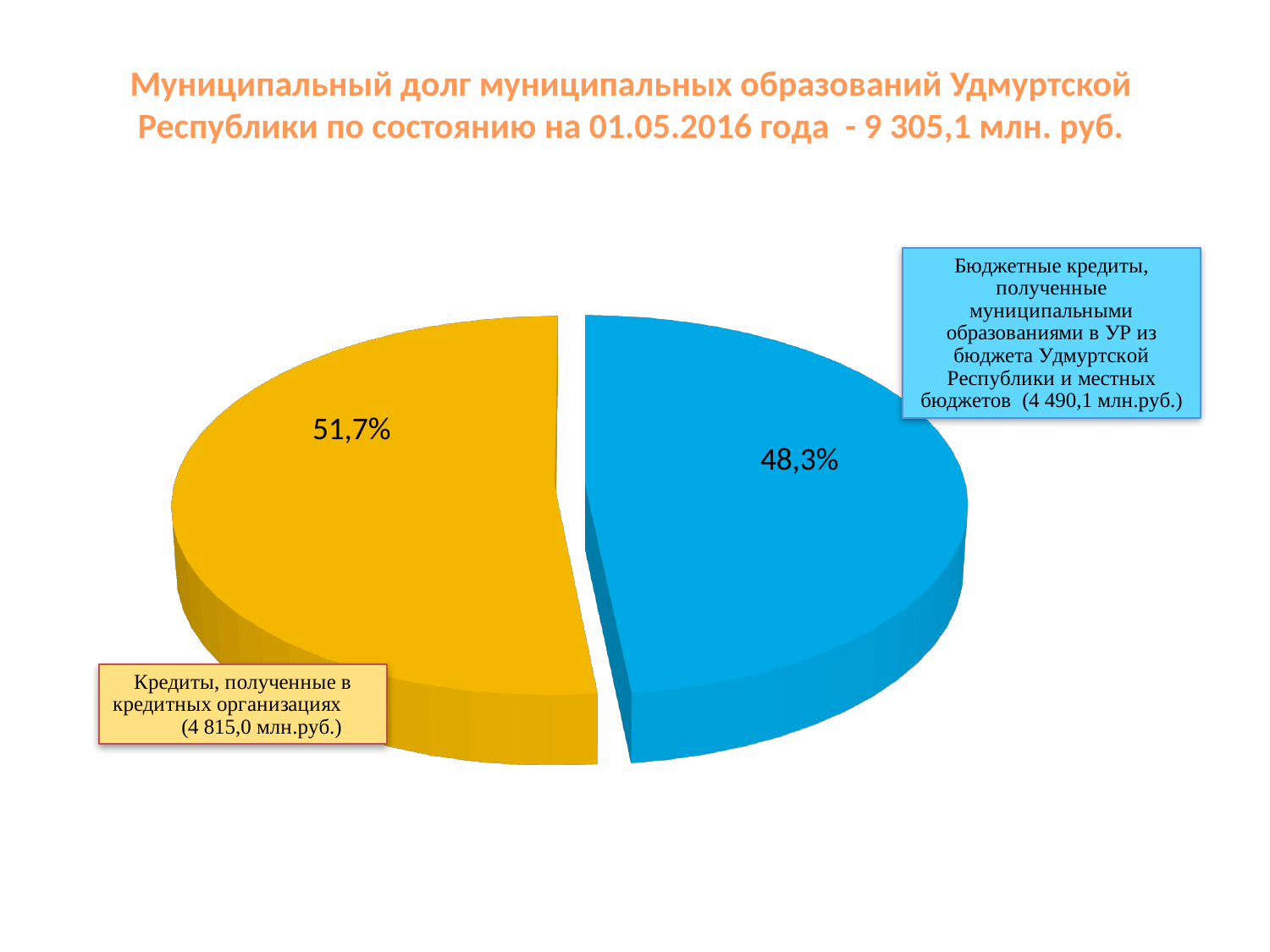
What amount in млн.руб. is given for 'Кредиты, полученные в кредитных организациях'? 4 815,0 млн.руб. Which slice is the smallest in the pie chart? Бюджетные кредиты, полученные муниципальными образованиями в УР из бюджета Удмуртской Республики и местных бюджетов What is the difference in percentage points between the 51,7% slice and the 48,3% slice? 3,4 What kind of chart is shown on the slide? Pie chart Which slice is the largest in the pie chart? Кредиты, полученные в кредитных организациях How many slices does the pie chart have? 2 What amount in млн.руб. is given for 'Бюджетные кредиты' received by municipalities? 4 490,1 млн.руб. What share of the pie is labelled for the slice 'Бюджетные кредиты, полученные муниципальными образованиями в УР из бюджета Удмуртской Республики и местных бюджетов'? 48,3% Which is larger: the share of 'Кредиты, полученные в кредитных организациях' or the share of 'Бюджетные кредиты'? Кредиты, полученные в кредитных организациях What share of the pie is labelled for the slice 'Кредиты, полученные в кредитных организациях'? 51,7% What colour is the slice representing 'Бюджетные кредиты'? Blue What total municipal debt amount is stated in the chart title? 9 305,1 млн. руб.